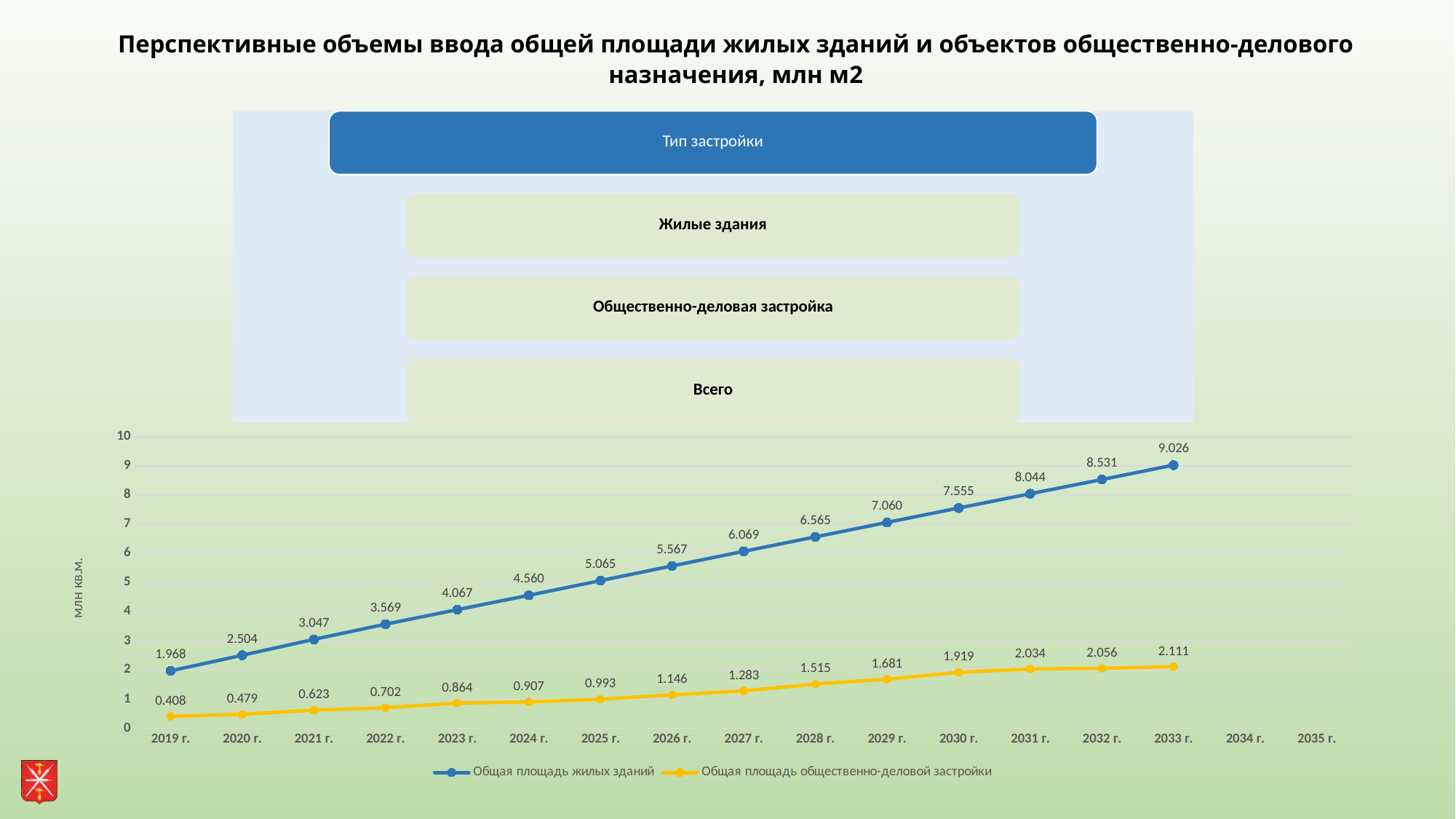
Which series has the larger value in 2030 г., Общая площадь жилых зданий or Общая площадь общественно-деловой застройки? Общая площадь жилых зданий In which year is Общая площадь жилых зданий lowest? 2019 г. What is the value for Общая площадь общественно-деловой застройки in 2019 г.? 0.408 By how much does Общая площадь жилых зданий increase from 2019 г. to 2033 г.? 7.058 In which year is Общая площадь общественно-деловой застройки highest? 2033 г. Does Общая площадь жилых зданий rise or fall from 2019 г. to 2033 г.? Rise What is the value for Общая площадь общественно-деловой застройки in 2028 г.? 1.515 What is the difference between Общая площадь жилых зданий and Общая площадь общественно-деловой застройки in 2033 г.? 6.915 What kind of chart is shown on the slide? Line chart What is the value for Общая площадь жилых зданий in 2025 г.? 5.065 What is the value for Общая площадь жилых зданий in 2033 г.? 9.026 How many series does the legend list? 2